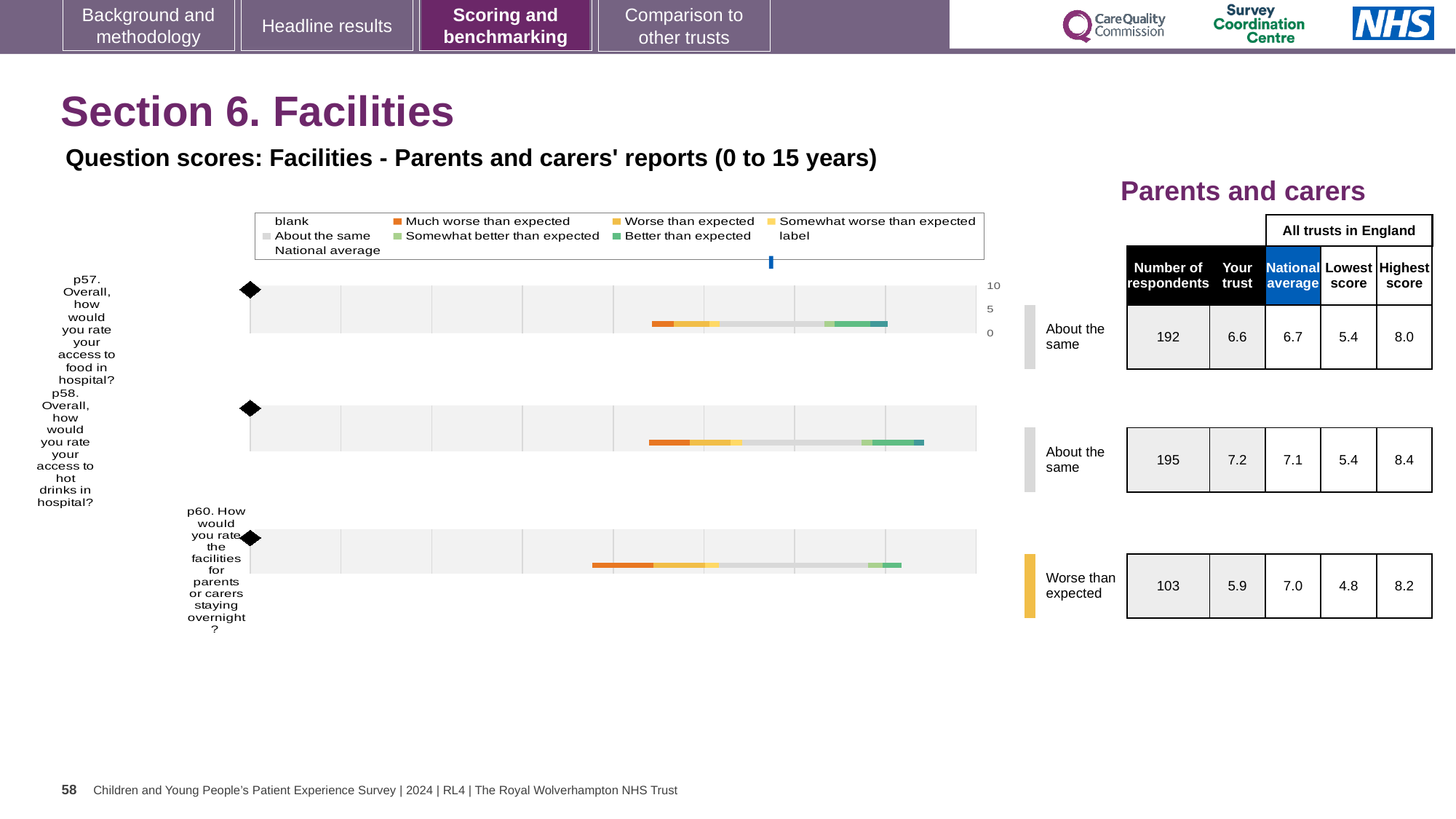
What benchmark category is shown for p60? Worse than expected Which question has the highest 'Your trust' score? p58 (access to hot drinks in hospital) How many questions (chart rows) are plotted on the slide? 3 How many respondents answered p60 (facilities for parents or carers staying overnight)? 103 What is the difference between the highest score and the lowest score for p58? 3.0 What is the difference between the national average and the 'Your trust' score for p57? 0.1 What is the national average score for p58 (access to hot drinks in hospital)? 7.1 For p60, is the 'Your trust' score higher or lower than the national average? lower What kind of chart is used to show the question scores for p57, p58 and p60? bar chart What is the highest tick value shown on the chart's score axis? 10 What is the 'Your trust' score for p57 (access to food in hospital)? 6.6 Which question has the lowest number of respondents? p60 (facilities for parents or carers staying overnight)